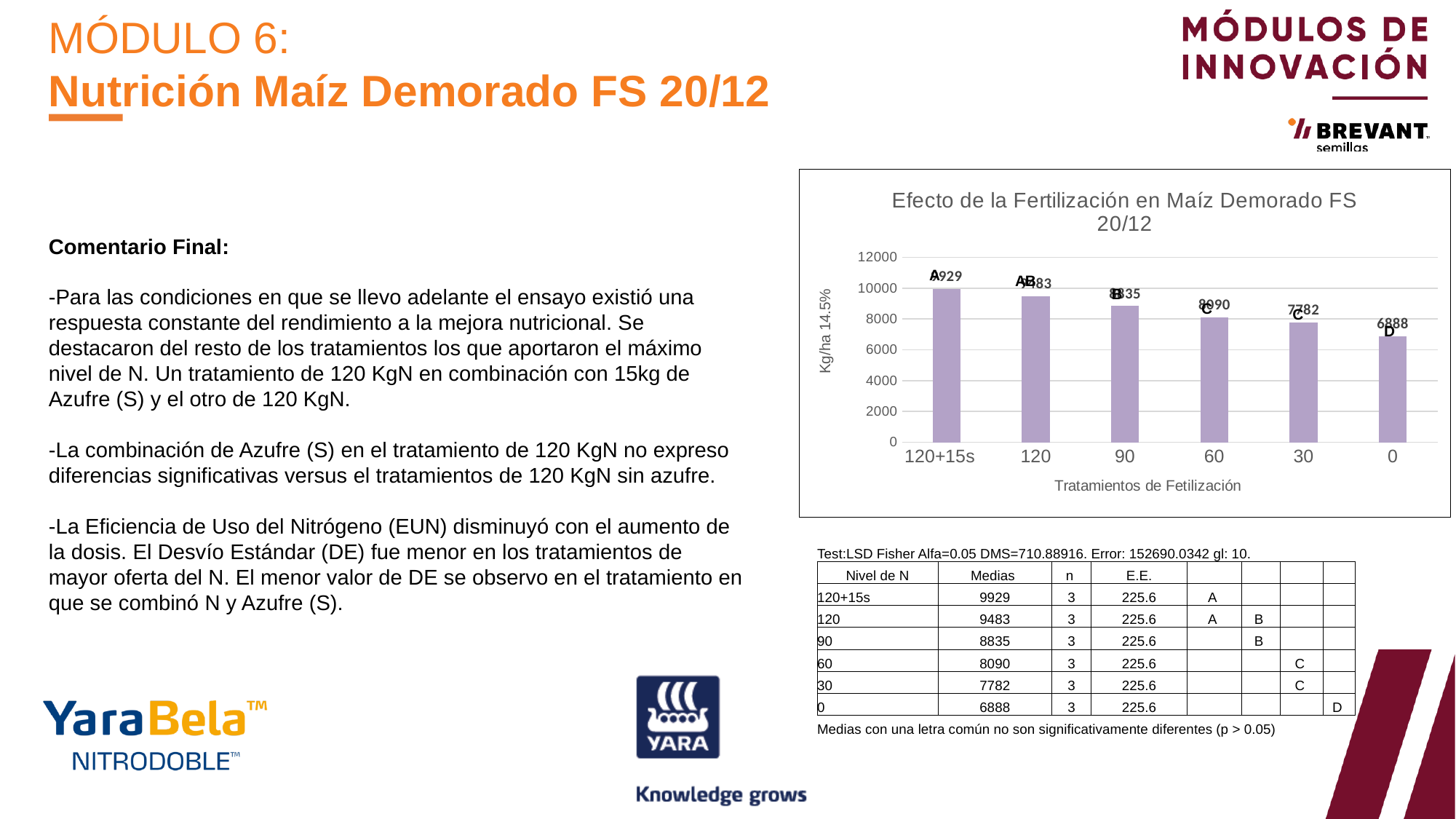
Which treatment has the lowest value? 0 Which is larger, the value for 90 or the value for 60? 90 What type of chart is shown on the slide? bar chart Which treatment has the highest value? 120+15s What is the title of the chart? Efecto de la Fertilización en Maíz Demorado FS 20/12 What is the value for the 90 treatment? 8835 What is the value for the 120+15s treatment? 9929 How many fertilization treatments are plotted on the x axis of the chart? 6 What is the difference between the values for 120+15s and 120? 446 What is the value for the 0 treatment? 6888 What is the difference between the values for 60 and 30? 308 Do the values rise or fall moving from left to right along the x axis? fall